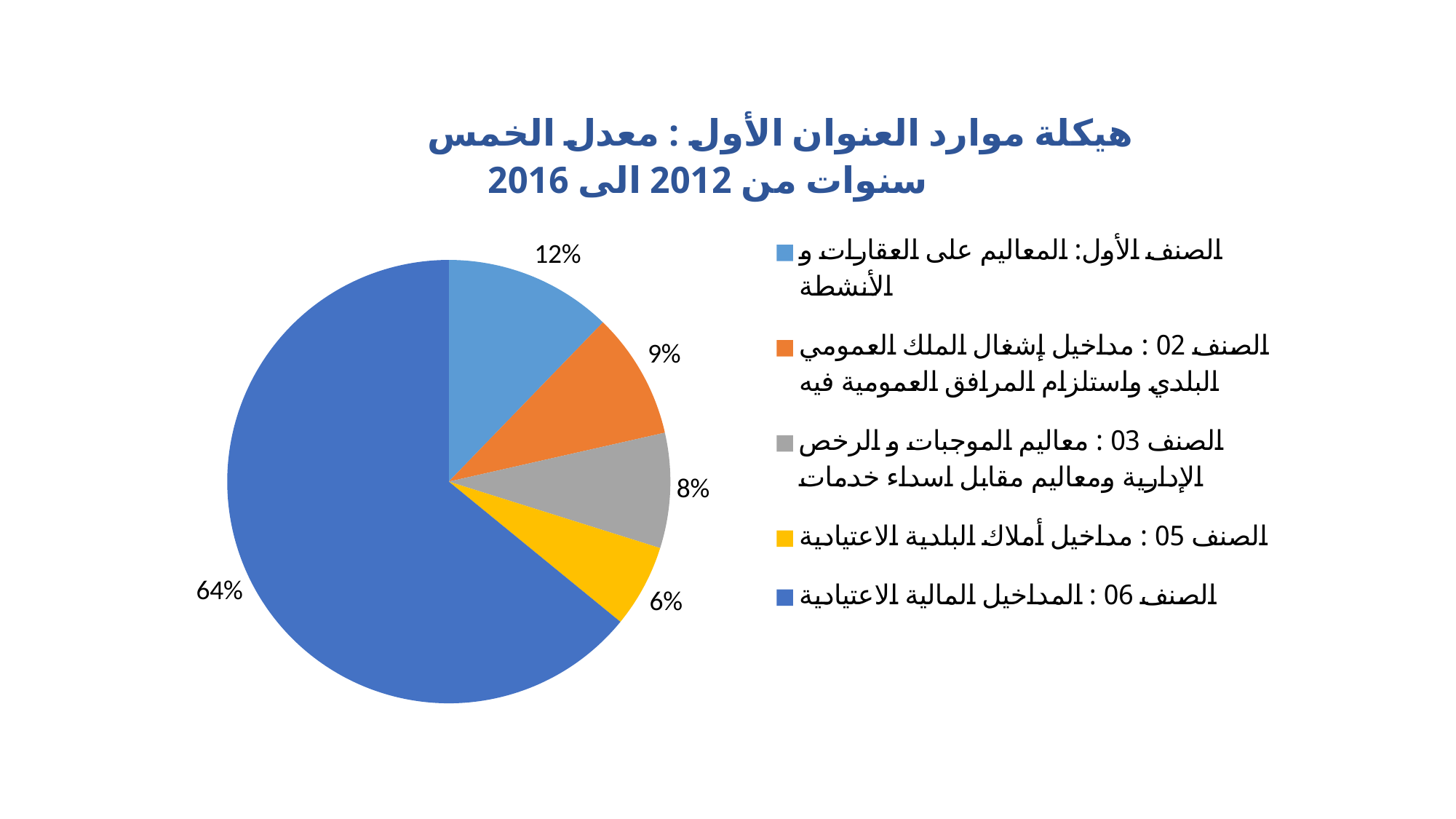
What share of the pie does الصنف 05 : مداخيل أملاك البلدية الاعتيادية have? 6% Which is larger, the slice for الصنف 02 or the slice for الصنف 03? الصنف 02 Which category has the largest slice of the pie? الصنف 06 : المداخيل المالية الاعتيادية How many slices does the pie chart have? 5 What share of the pie does الصنف 06 : المداخيل المالية الاعتيادية have? 64% What is the difference in percentage points between الصنف 06 and الصنف الأول? 52 What share of the pie does الصنف الأول: المعاليم على العقارات و الأنشطة have? 12% What kind of chart is shown on the slide? Pie chart What share of the pie does الصنف 03 : معاليم الموجبات و الرخص الإدارية ومعاليم مقابل اسداء خدمات have? 8% How many entries does the legend list? 5 What colour is the slice for الصنف 05 : مداخيل أملاك البلدية الاعتيادية? Yellow Which category has the smallest slice of the pie? الصنف 05 : مداخيل أملاك البلدية الاعتيادية